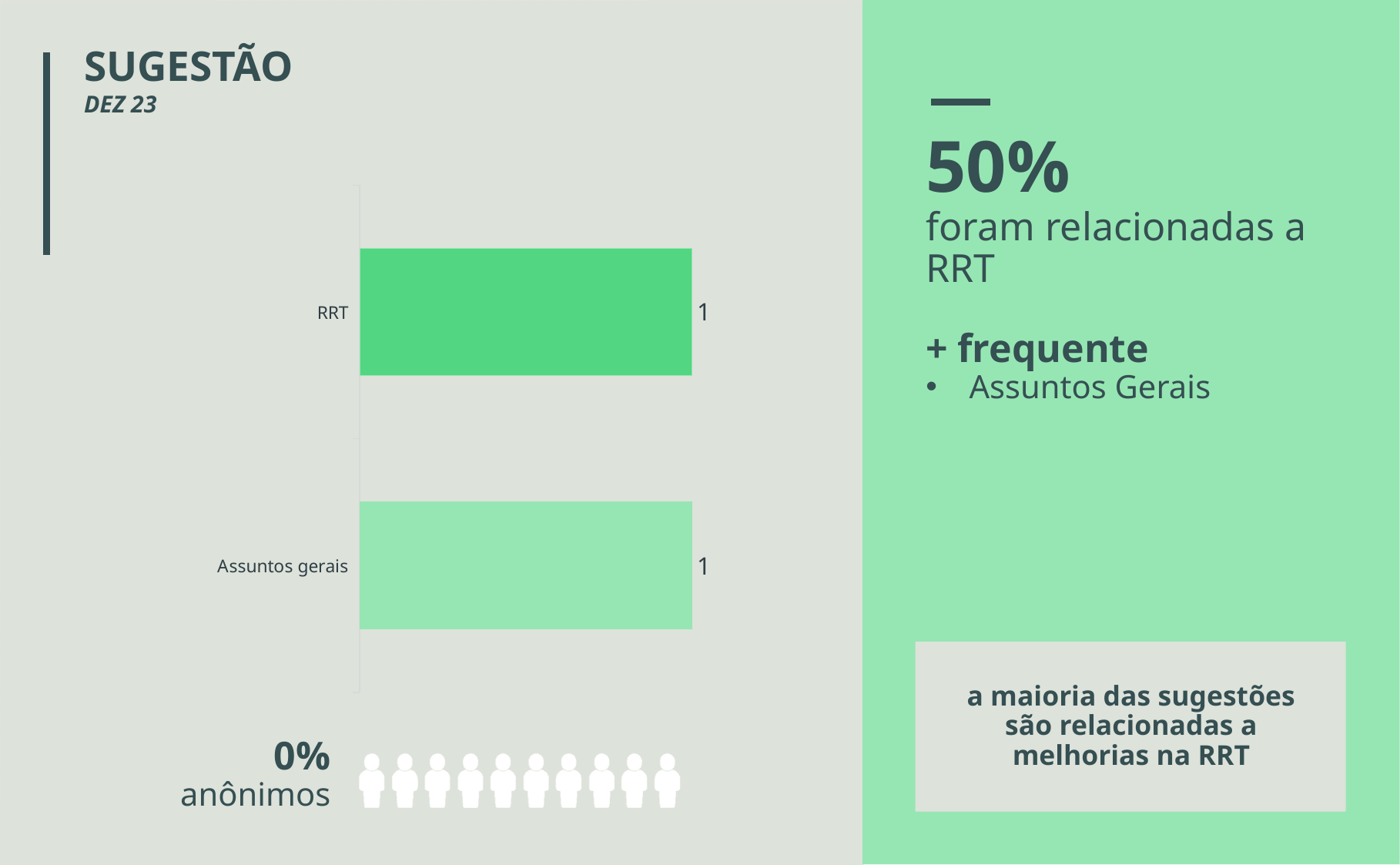
Are the values for RRT and Assuntos gerais equal? Yes How many categories does the bar chart show? 2 What is the difference between the values for RRT and Assuntos gerais? 0 What is the value for RRT? 1 Which category is listed at the top of the bar chart? RRT What is the total of the values for RRT and Assuntos gerais? 2 What is the value for Assuntos gerais? 1 Are the bars in the chart horizontal or vertical? horizontal What kind of chart is shown on the slide? bar chart